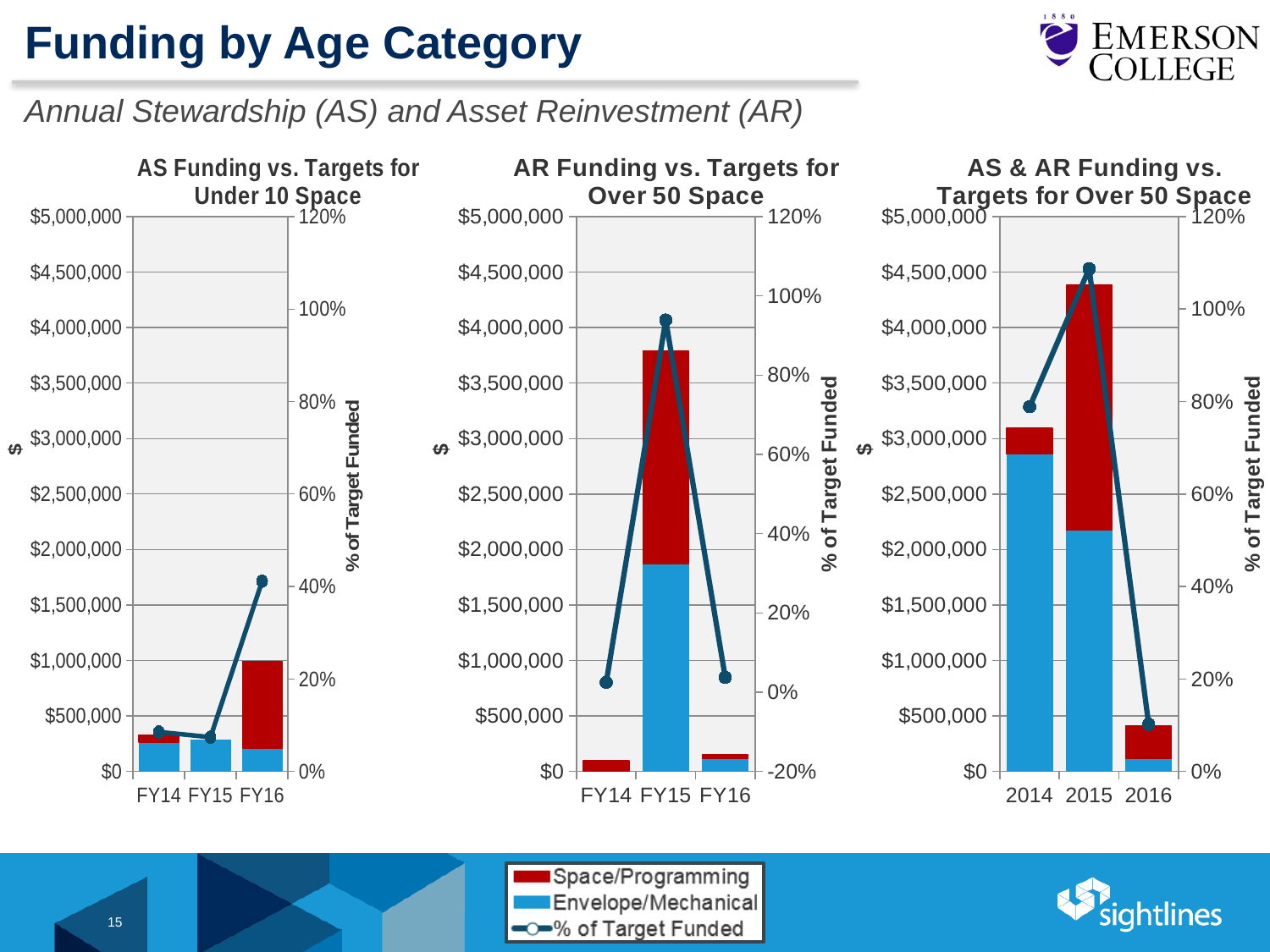
How many fiscal years are shown on the x axis of the 'AS Funding vs. Targets for Under 10 Space' chart? 3 What kind of chart is the 'AR Funding vs. Targets for Over 50 Space' chart? Combination bar and line chart In the 'AS & AR Funding vs. Targets for Over 50 Space' chart, is the % of Target Funded for 2015 greater or less than 100%? greater In the 'AS & AR Funding vs. Targets for Over 50 Space' chart, which year has the highest total funding bar? 2015 How many series does the shared legend at the bottom of the slide list? 3 In the 'AS & AR Funding vs. Targets for Over 50 Space' chart, which year has the larger total funding bar, 2014 or 2016? 2014 In the 'AS & AR Funding vs. Targets for Over 50 Space' chart, which year has the lowest total funding bar? 2016 According to the legend, which series is shown in red? Space/Programming In the 'AS Funding vs. Targets for Under 10 Space' chart, is the % of Target Funded for FY16 greater or less than 60%? less In the 'AR Funding vs. Targets for Over 50 Space' chart, which fiscal year has the highest total funding bar? FY15 In the 'AS Funding vs. Targets for Under 10 Space' chart, which fiscal year has the highest total funding bar? FY16 In the 'AR Funding vs. Targets for Over 50 Space' chart, is the total funding for FY15 greater or less than $3,500,000? greater